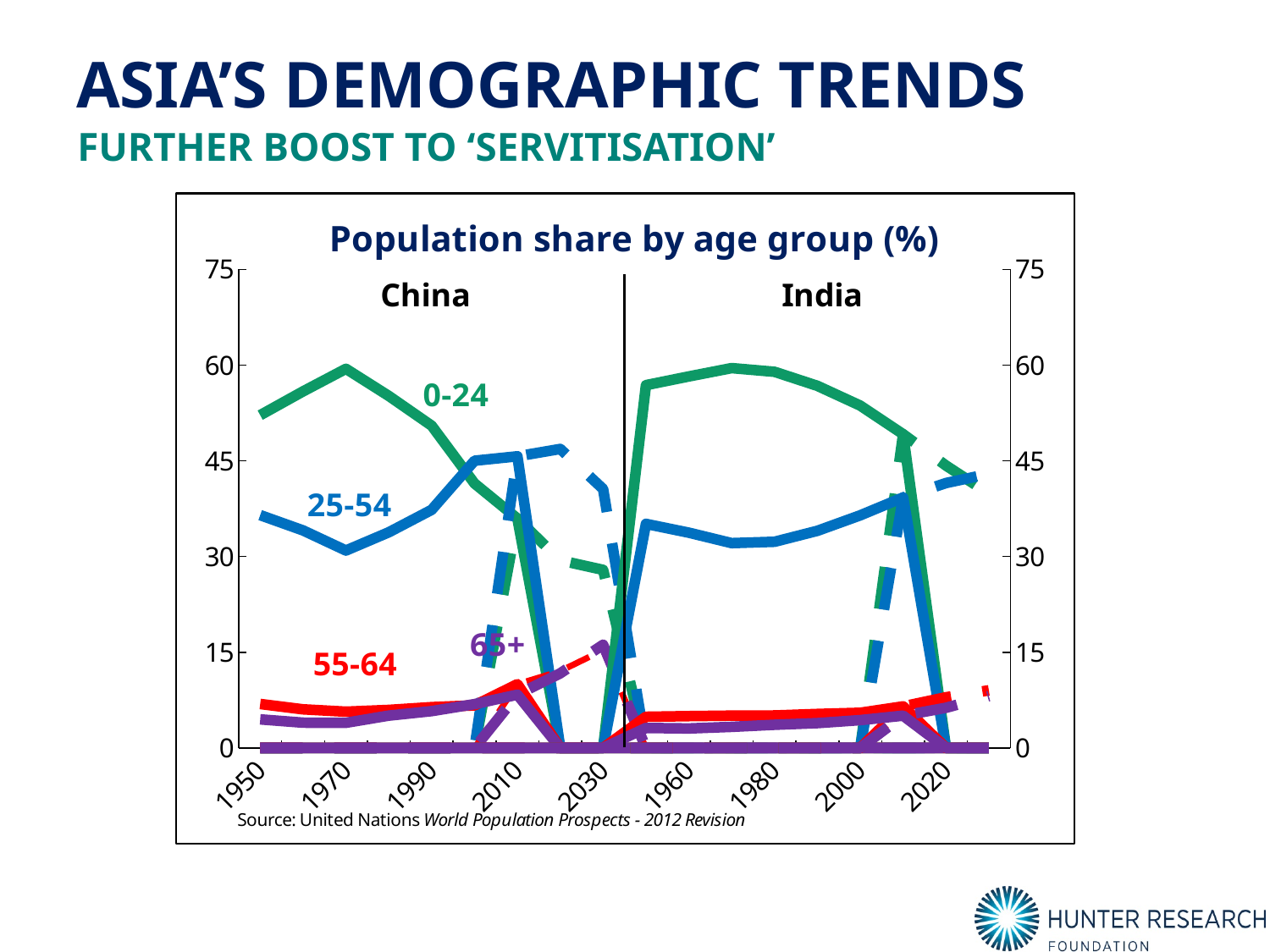
In the China panel, is the value for the 0-24 age group in 1970 greater or less than 45? greater Which two countries are shown in the two panels of the chart? China and India In the China panel, does the share of the 0-24 age group rise or fall between 1970 and 2010? fall In the China panel, is the value for the 25-54 age group in 1970 greater or less than 45? less What kind of chart is shown on the slide? line chart In the India panel, is the value for the 0-24 age group in 1980 greater or less than 45? greater In the India panel, does the share of the 25-54 age group rise or fall between 1980 and 2010? rise In the China panel, which age group has the highest population share in 1970? 0-24 What is the title of the chart? Population share by age group (%) In the India panel in 1960, which is larger, the share of the 0-24 age group or the 25-54 age group? 0-24 How many age groups are labelled on the chart? 4